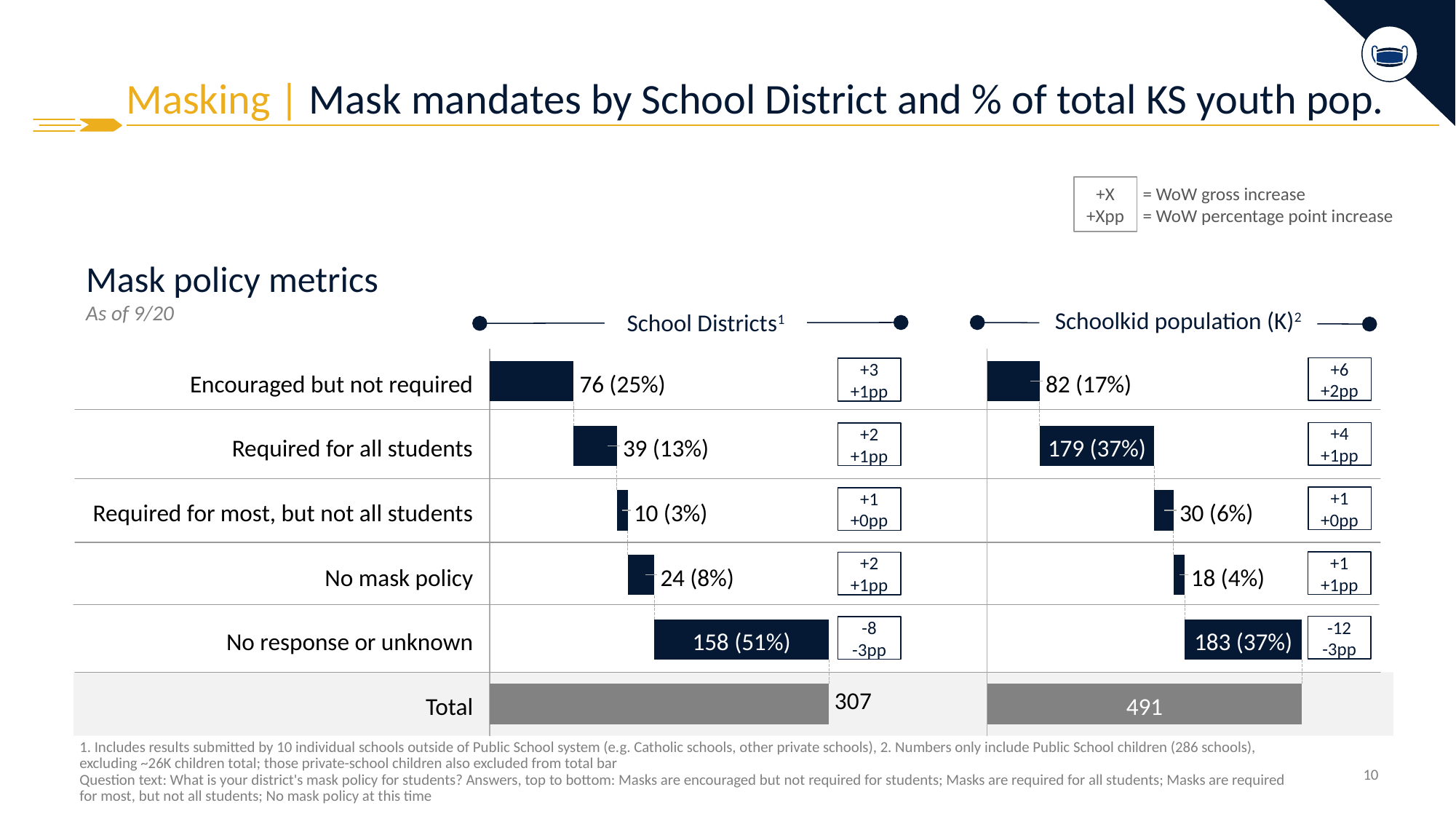
How many mask policy categories (excluding Total) are listed in each chart? 5 In the School Districts chart, how many school districts are in the 'Encouraged but not required' category? 76 (25%) What is the Total shown in the School Districts chart? 307 In the Schoolkid population (K) chart, which category has the lowest value? No mask policy In the Schoolkid population (K) chart, what is the WoW gross change shown for 'No response or unknown'? -12 What is the Total shown in the Schoolkid population (K) chart? 491 In the School Districts chart, which category has the lowest value? Required for most, but not all students In the School Districts chart, what is the difference between 'No response or unknown' and 'Encouraged but not required'? 82 In the Schoolkid population (K) chart, what is the value for 'Required for all students'? 179 (37%) In the Schoolkid population (K) chart, which is larger: 'Encouraged but not required' or 'Required for all students'? Required for all students In the School Districts chart, which category has the highest value? No response or unknown What kind of chart is used to show the mask policy metrics? Bar chart